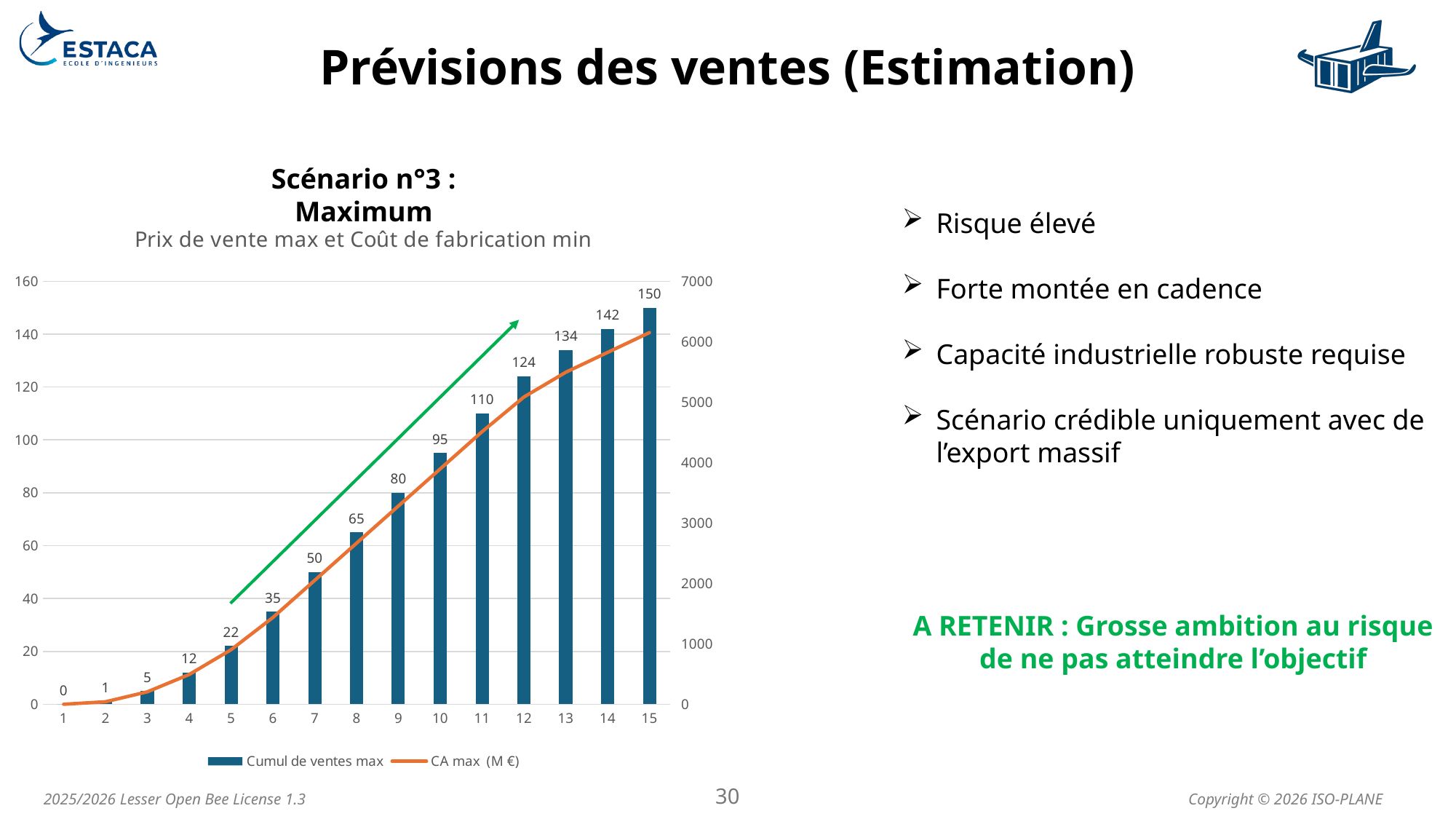
Do the 'Cumul de ventes max' values rise or fall from category 1 to category 15? rise What is the difference between the 'Cumul de ventes max' values for categories 12 and 10? 29 Which is larger, the 'Cumul de ventes max' value for category 7 or for category 9? category 9 Which category has the highest 'Cumul de ventes max' value? 15 What is the value of 'Cumul de ventes max' for category 4? 12 What is the subtitle shown under 'Scénario n°3 : Maximum'? Prix de vente max et Coût de fabrication min Is the 'CA max (M €)' value for category 15 greater or less than 5000? greater What is the value of 'Cumul de ventes max' for category 15? 150 Which category has the lowest 'Cumul de ventes max' value? 1 How many categories are shown on the x axis? 15 How many series does the legend list? 2 What is the value of 'Cumul de ventes max' for category 8? 65